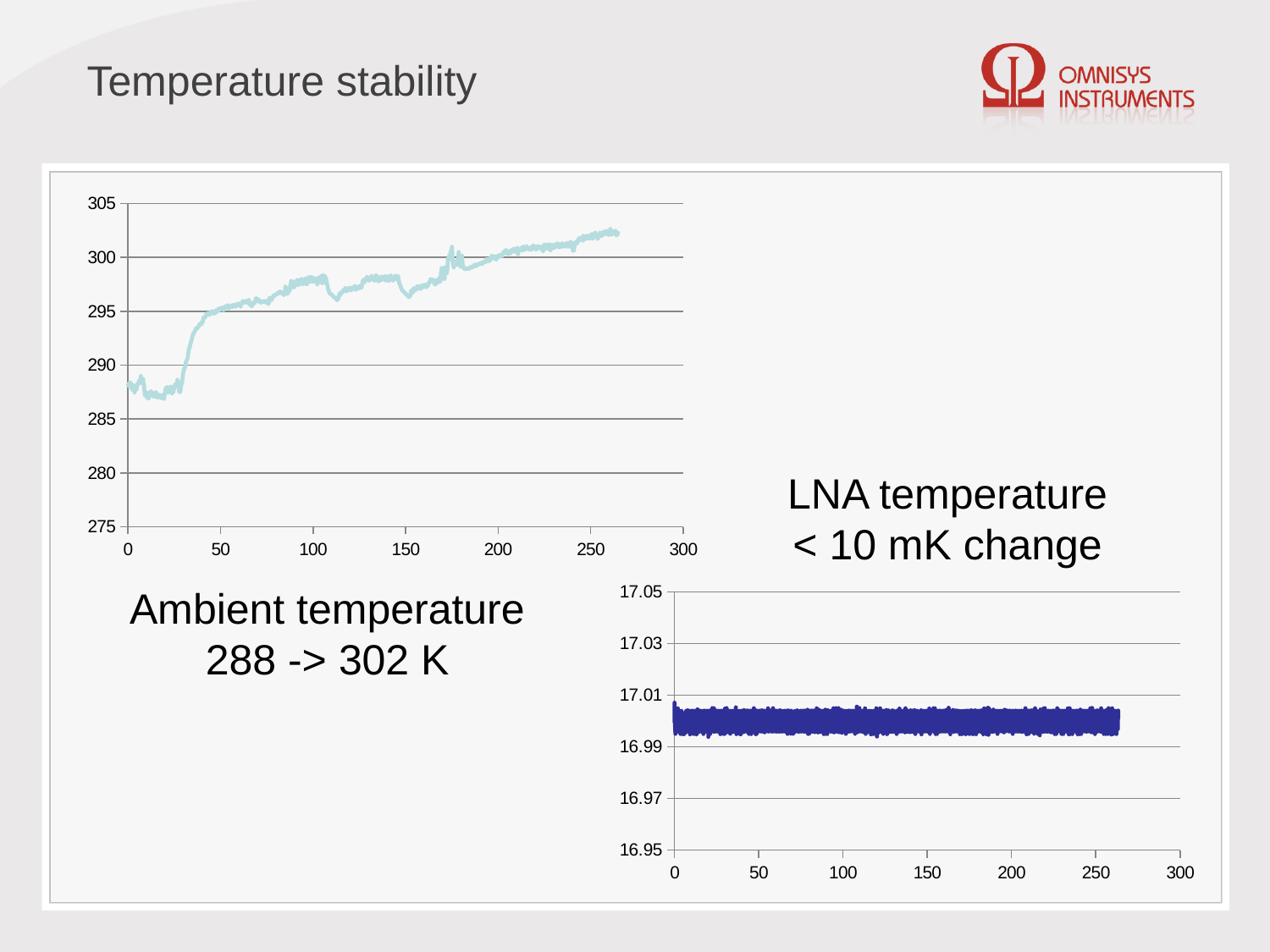
In the top-left chart (ambient temperature), is the value at x = 250 greater or less than 300? greater How many charts are shown on the slide? 2 In the bottom-right chart (LNA temperature), is the value at x = 100 greater or less than 16.97? greater What kind of chart is the bottom-right chart (LNA temperature)? line chart What is the highest value shown on the y axis of the bottom-right chart (LNA temperature)? 17.05 In the top-left chart (ambient temperature), is the value at x = 100 greater or less than 295? greater In the bottom-right chart (LNA temperature), do the values rise, fall, or stay roughly flat along the x axis? stay roughly flat In the top-left chart (ambient temperature), do the values generally rise or fall along the x axis? rise What kind of chart is the top-left chart (ambient temperature)? line chart